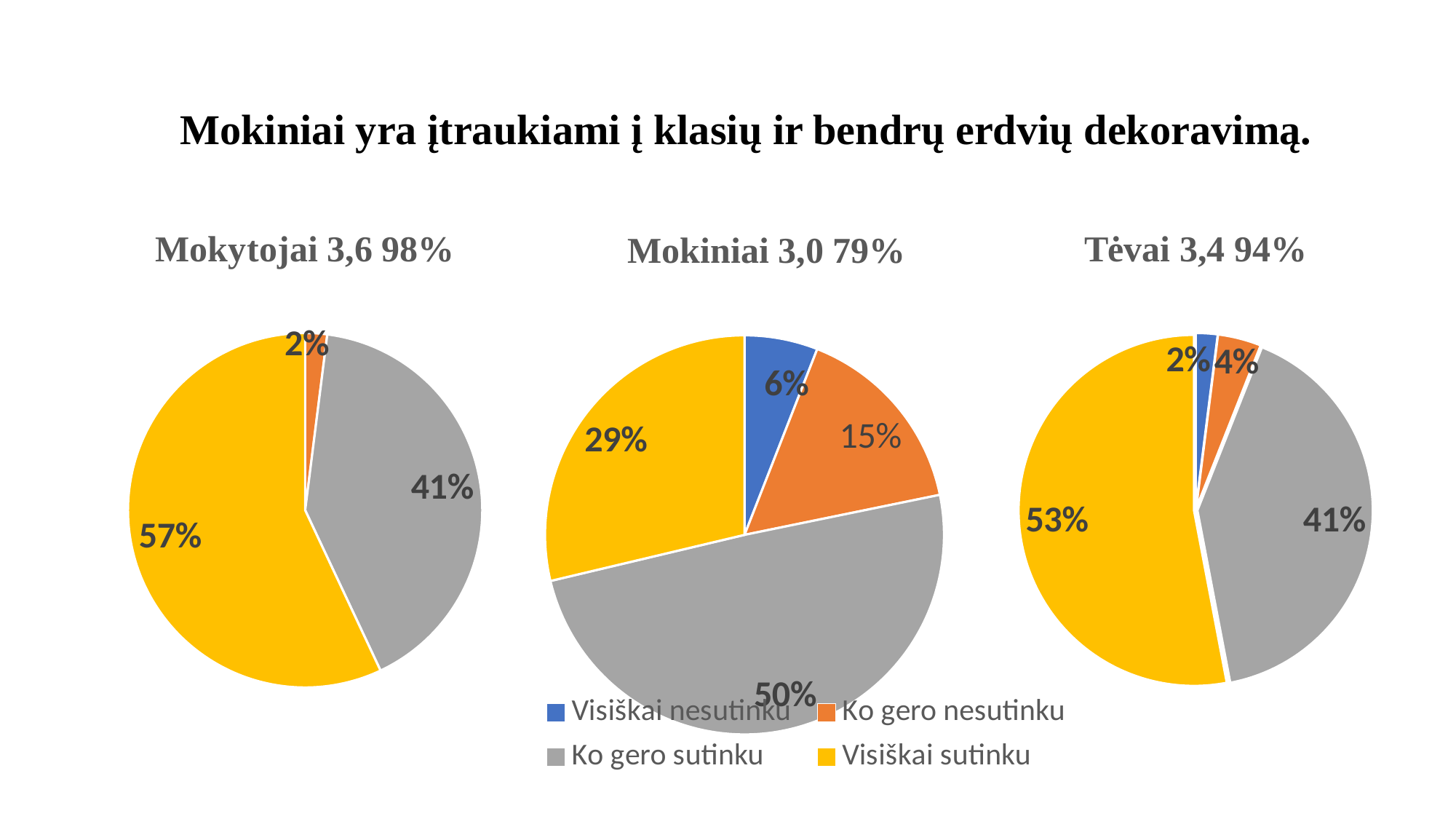
Which colour represents 'Ko gero sutinku' in the legend? Grey How many series does the legend list? 4 In the 'Tėvai 3,4 94%' pie chart, what share is 'Visiškai sutinku'? 53% In the 'Mokytojai 3,6 98%' pie chart, what share is 'Ko gero sutinku'? 41% In the 'Tėvai 3,4 94%' pie chart, which category has the smallest share? Visiškai nesutinku In the 'Mokytojai 3,6 98%' pie chart, what share is 'Visiškai sutinku'? 57% In the 'Mokiniai 3,0 79%' pie chart, which category has the largest share? Ko gero sutinku What kind of charts are shown on the slide? Pie charts Which is larger in the 'Mokiniai 3,0 79%' pie chart: 'Visiškai sutinku' or 'Ko gero nesutinku'? Visiškai sutinku In the 'Mokiniai 3,0 79%' pie chart, what share is 'Visiškai nesutinku'? 6% In the 'Mokytojai 3,6 98%' pie chart, what is the difference between the 'Visiškai sutinku' and 'Ko gero sutinku' shares? 16% In the 'Mokiniai 3,0 79%' pie chart, what share is 'Ko gero nesutinku'? 15%